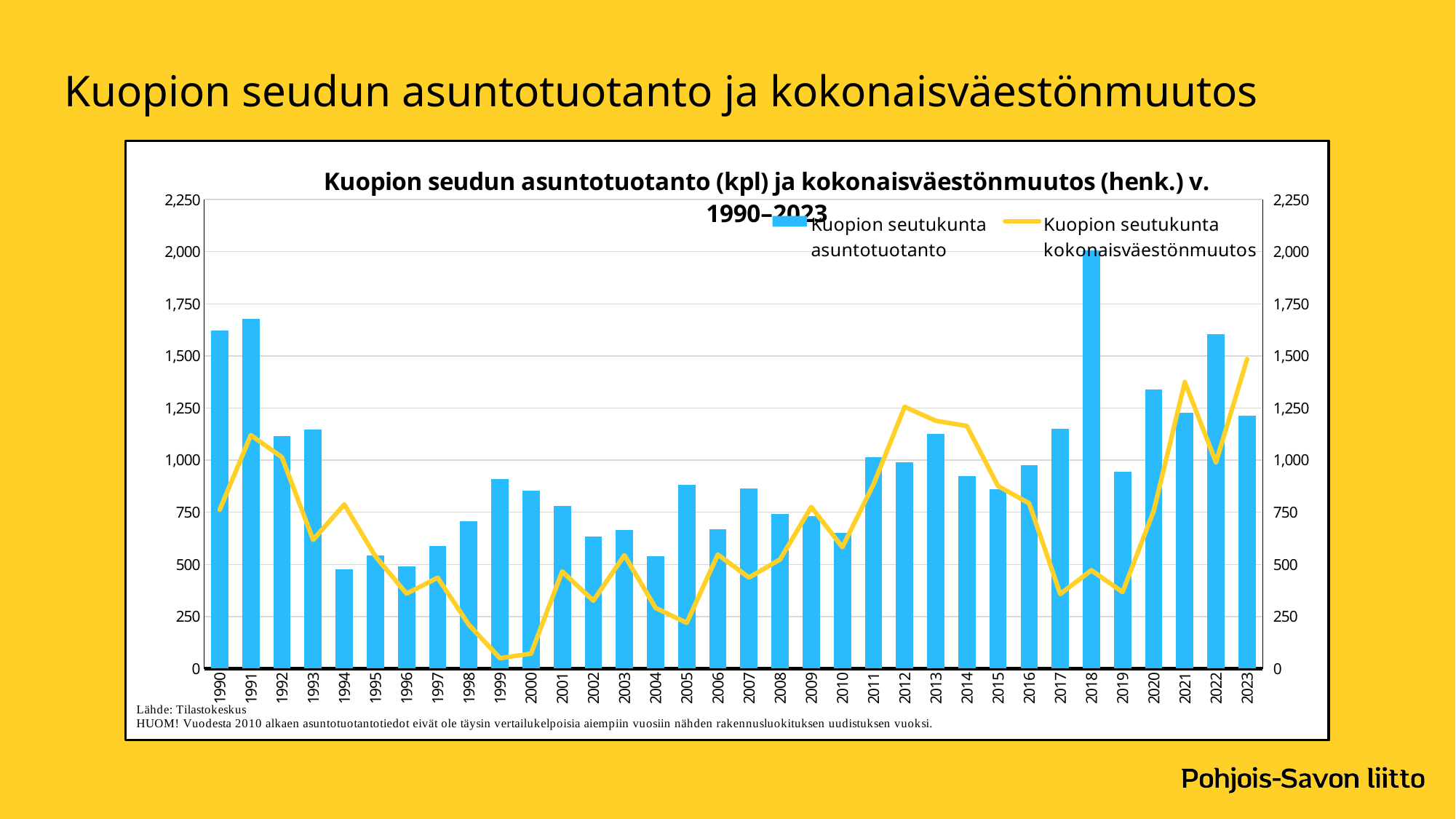
Does the kokonaisväestönmuutos line rise or fall from 2019 to 2023? rise How many series does the legend list? 2 In which year is the bar for Kuopion seutukunta asuntotuotanto highest? 2018 Is the asuntotuotanto bar for 1994 greater or less than 500? less Is the asuntotuotanto bar for 2018 greater or less than 1,750? greater In which year does the Kuopion seutukunta kokonaisväestönmuutos line reach its highest value? 2023 Is the kokonaisväestönmuutos value for 2012 greater or less than 1,000? greater What kind of chart is shown on the slide? A combined bar and line chart How many years are shown on the x axis? 34 Which year has the larger asuntotuotanto bar, 2020 or 2022? 2022 In which year is the Kuopion seutukunta kokonaisväestönmuutos line at its lowest? 1999